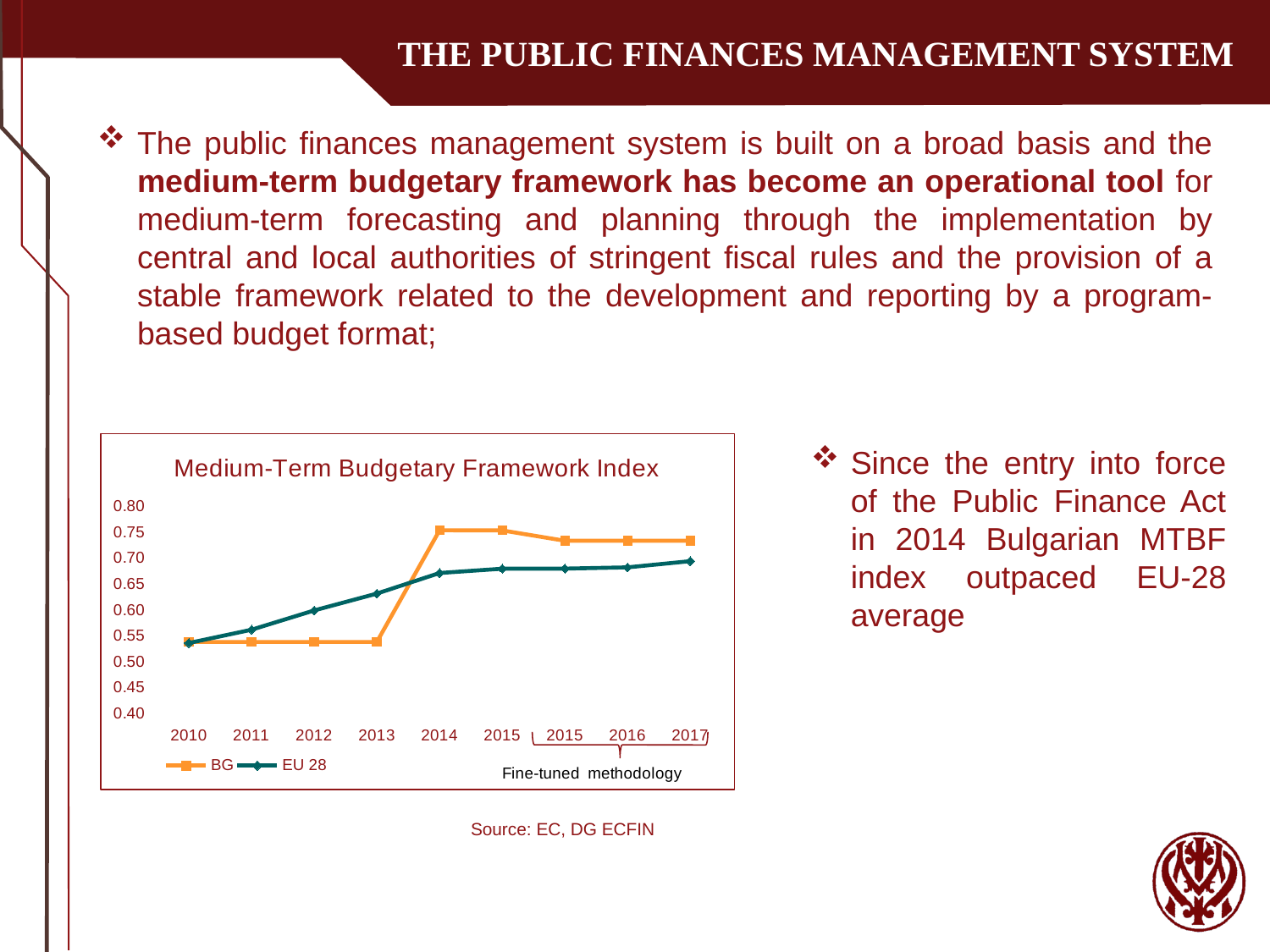
Which two series are listed in the chart's legend? BG and EU 28 In 2014, which series has the higher value, BG or EU 28? BG How many series does the chart's legend list? 2 Is the EU 28 value for 2010 greater or less than 0.60? less Is the EU 28 value for 2017 greater or less than 0.75? less In 2012, which series has the higher value, BG or EU 28? EU 28 Is the BG value for 2012 greater or less than 0.60? less Does the EU 28 series generally rise or fall from 2010 to 2017? rise What kind of chart is shown on the slide? line chart What is the title of the chart? Medium-Term Budgetary Framework Index How many points are plotted along the x axis for each series? 9